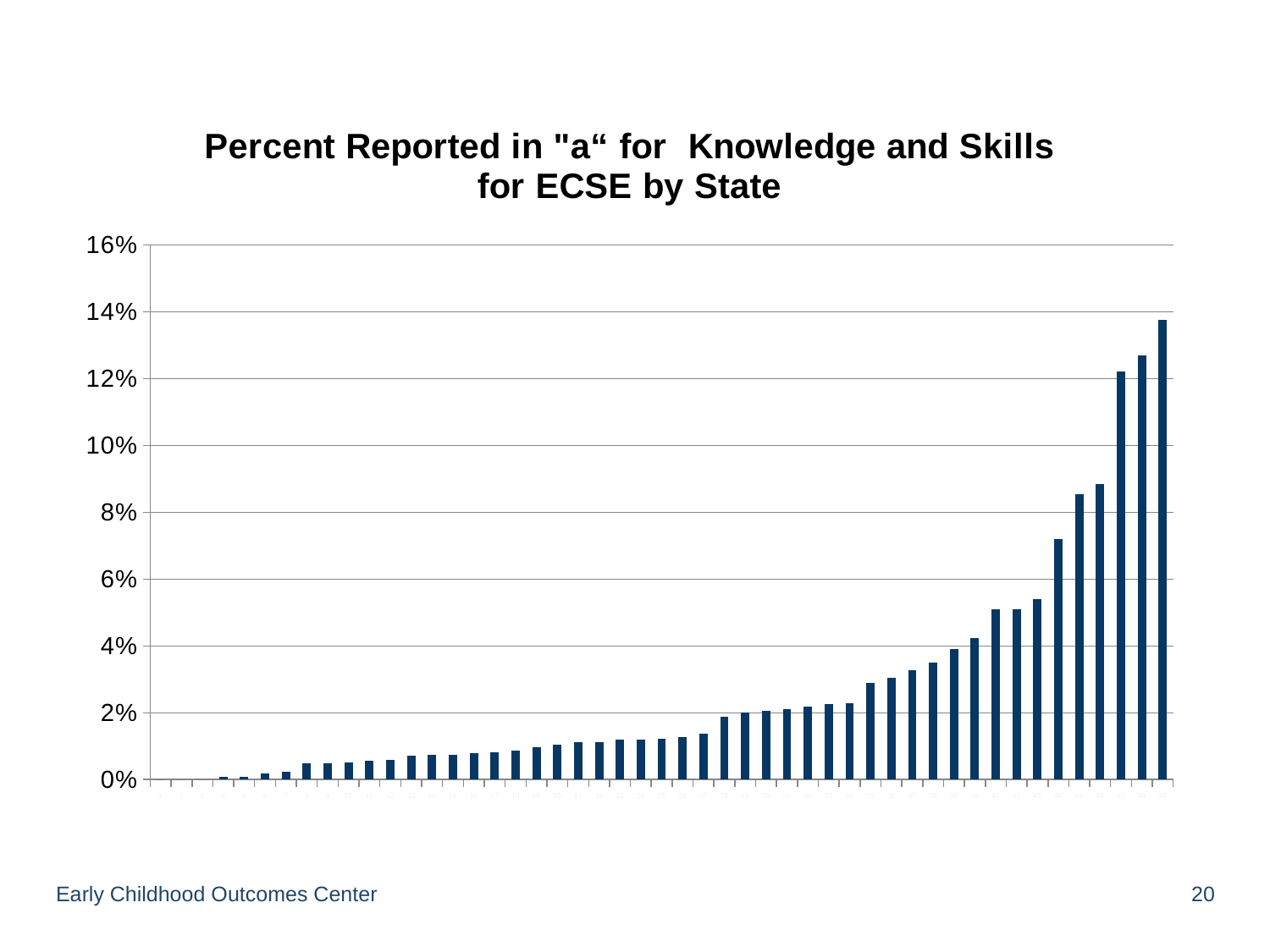
What kind of chart is shown on the slide? bar chart What is the title of the chart? Percent Reported in "a" for Knowledge and Skills for ECSE by State What is the highest value shown on the y axis? 16% Which bar is the tallest: the leftmost bar or the rightmost bar? the rightmost bar Is the value of the tallest bar greater or less than 14%? less Is the value of the fourth-tallest bar greater or less than 8%? greater Is the value of the fourth-tallest bar greater or less than 10%? less Do the bar values rise or fall moving from left to right along the x axis? rise